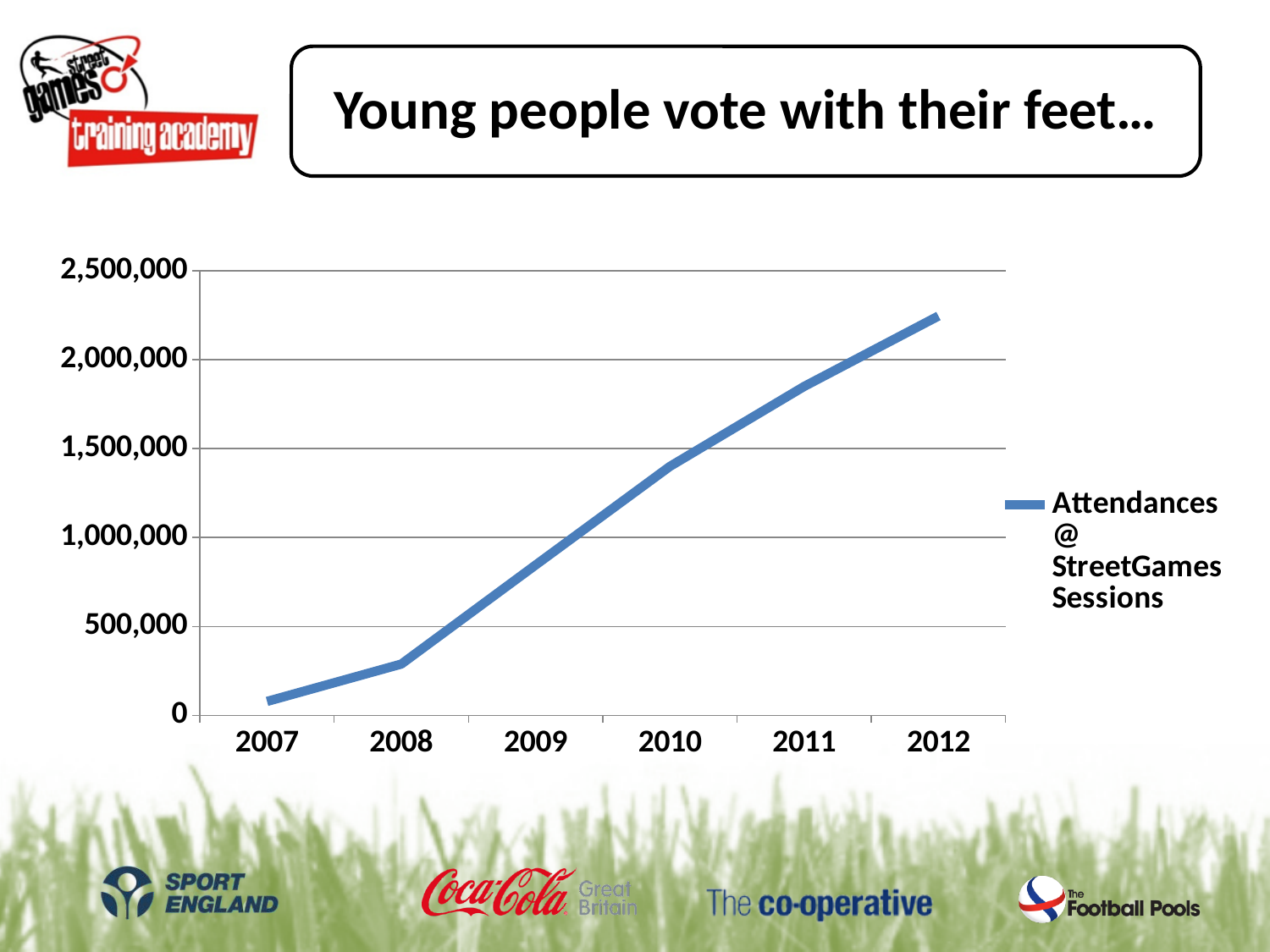
Do attendances rise or fall from 2007 to 2012? rise What kind of chart is shown on the slide? line chart How many years are plotted along the x axis? 6 Is the value for 2010 greater or less than 1,000,000? greater Which year has higher attendances, 2009 or 2011? 2011 What is the title shown above the chart? Young people vote with their feet… Which year has the highest attendances at StreetGames sessions? 2012 Which year has the lowest attendances at StreetGames sessions? 2007 Is the value for 2012 greater or less than 2,000,000? greater Is the value for 2008 greater or less than 500,000? less How many series does the legend list? 1 What series name is shown in the legend? Attendances @ StreetGames Sessions